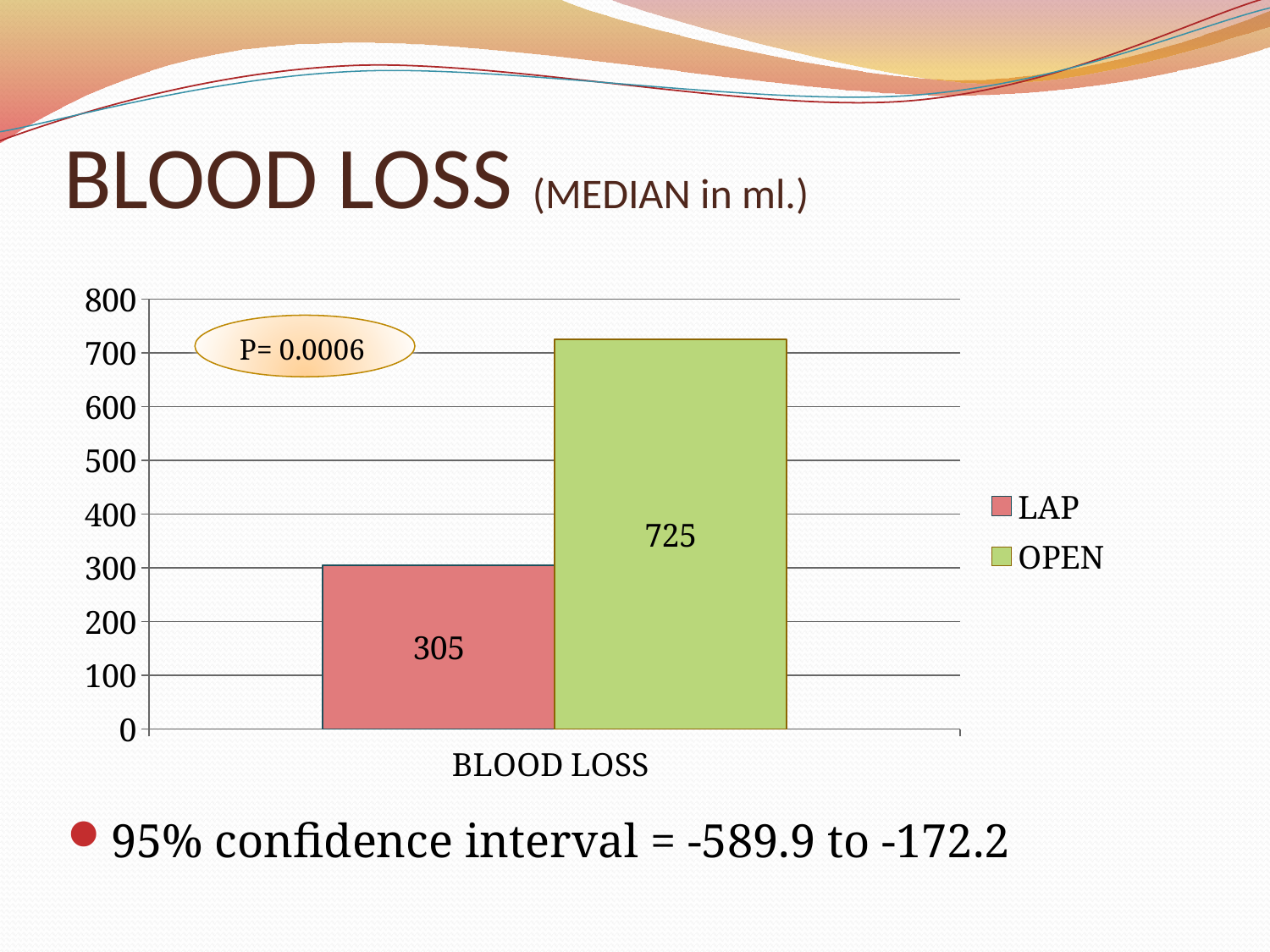
What P value is shown on the chart? P= 0.0006 Is the value for OPEN greater or less than 600? greater Which series has the lower blood loss value? LAP What is the category label on the x axis of the chart? BLOOD LOSS What is the difference between the OPEN and LAP blood loss values? 420 What is the median blood loss value for LAP? 305 What kind of chart is shown on the slide? bar chart What is the maximum value shown on the y axis? 800 Is the value for LAP greater or less than 400? less Which series has the higher blood loss value, LAP or OPEN? OPEN How many series does the legend list? 2 What is the median blood loss value for OPEN? 725